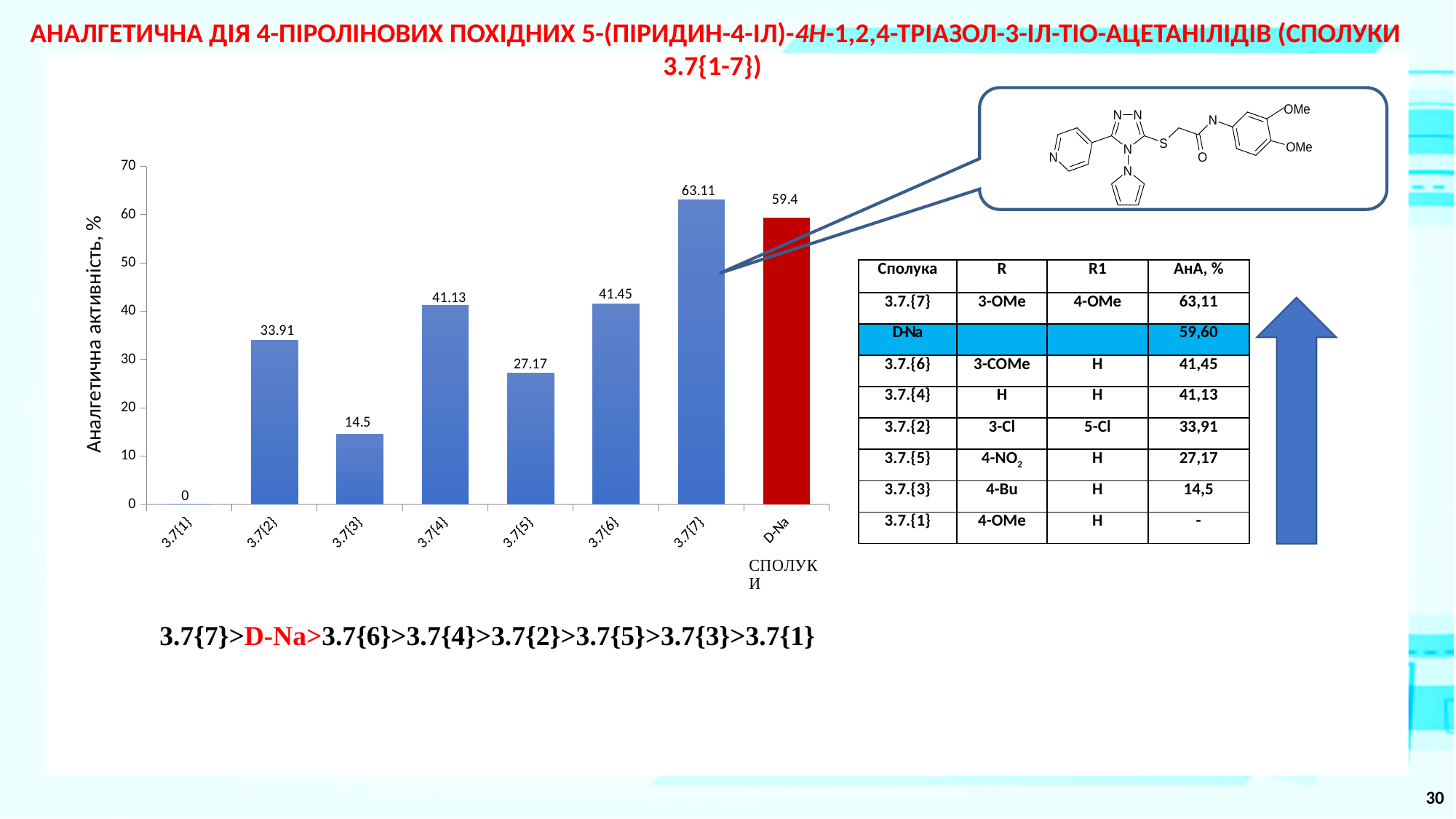
Which category has the highest bar in the chart? 3.7{7} Which category has the lowest bar in the chart? 3.7{1} What is the value shown for D-Na in the bar chart? 59.4 What is the label of the vertical axis of the chart? Аналгетична активність, % What is the value shown for 3.7{7} in the bar chart? 63.11 What is the difference between the values for 3.7{7} and D-Na? 3.71 Which is larger, the value for 3.7{4} or the value for 3.7{5}? 3.7{4} What is the value shown for 3.7{3} in the bar chart? 14.5 How many categories are shown on the x axis of the bar chart? 8 What kind of chart is shown on the slide? bar chart What is the difference between the values for 3.7{2} and 3.7{3}? 19.41 Is the value for 3.7{6} greater or less than 40? greater